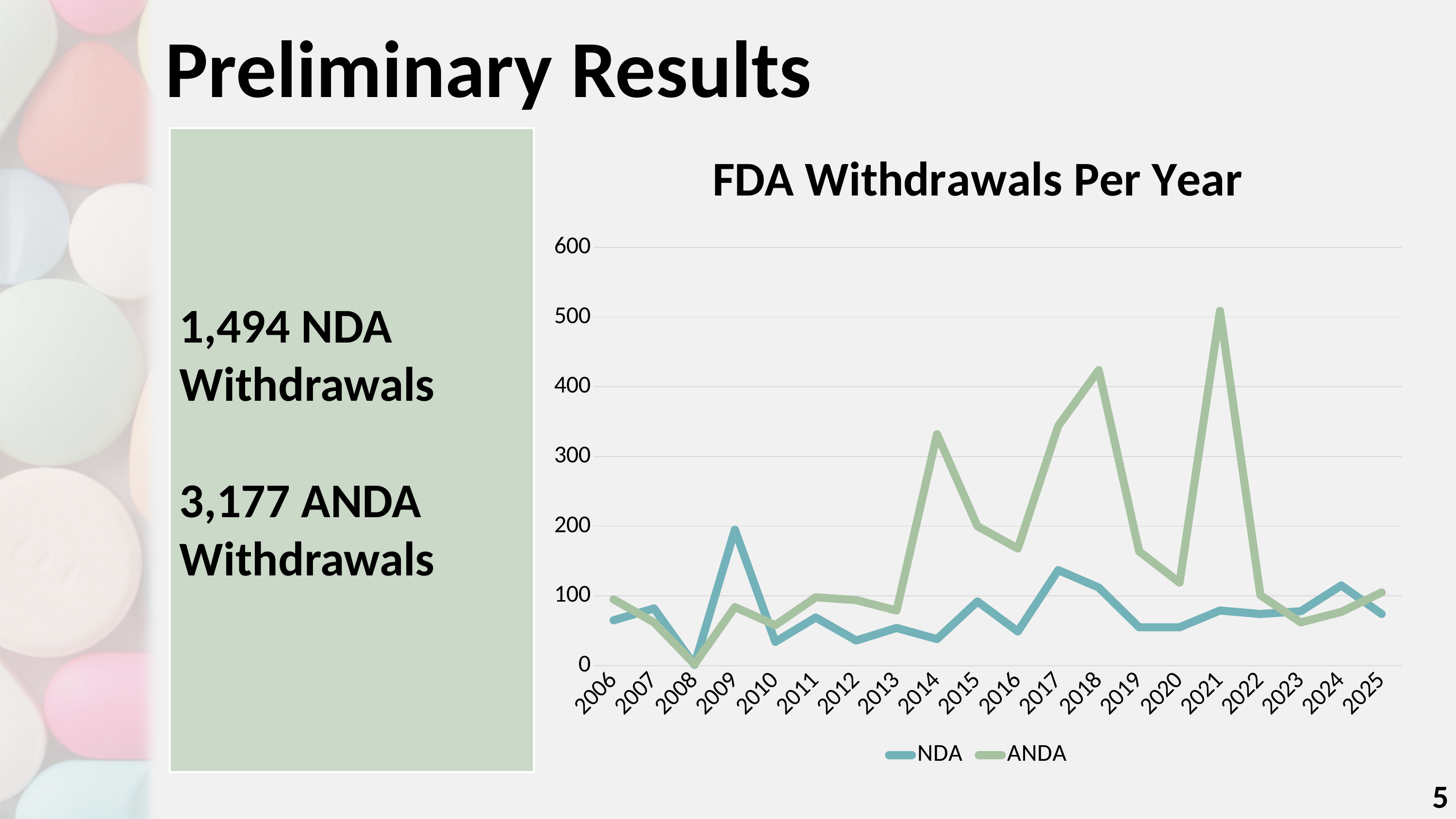
How many years are plotted along the x axis of the "FDA Withdrawals Per Year" chart? 20 Is the ANDA value for 2014 greater or less than 300? greater In which year does the ANDA series reach its highest value? 2021 What is the title of the chart on the slide? FDA Withdrawals Per Year How many series does the legend of the "FDA Withdrawals Per Year" chart list? 2 Is the NDA value for 2012 greater or less than 100? less Is the ANDA value for 2021 greater or less than 400? greater In 2009, which series has the larger value, NDA or ANDA? NDA In which year does the ANDA series reach its lowest value? 2008 What kind of chart is the "FDA Withdrawals Per Year" chart? line chart In 2021, which series has the larger value, NDA or ANDA? ANDA In which year does the NDA series reach its highest value? 2009